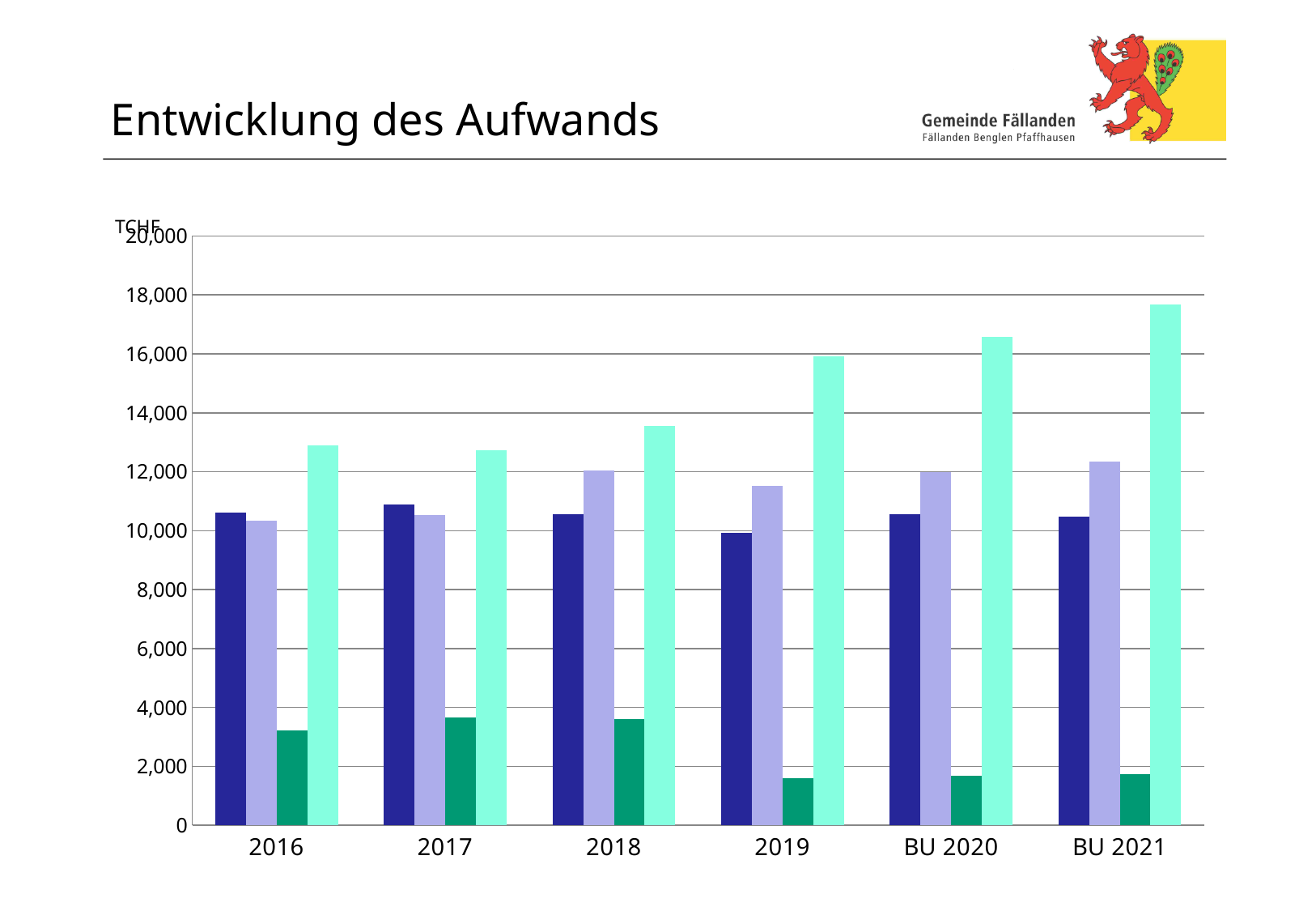
What unit label is shown at the top of the y axis? TCHF Is the value of the green bar for 2017 greater or less than 4,000? less Is the value of the light cyan bar for BU 2021 greater or less than 16,000? greater What kind of chart is shown on the slide? bar chart How many bars are plotted for each category? 4 Do the light cyan bars rise or fall from 2018 to BU 2021? rise How many categories are shown along the x axis? 6 Is the value of the light cyan bar for 2016 greater or less than 12,000? greater Which category has the tallest light cyan bar? BU 2021 Which category has the shortest dark blue bar? 2019 In 2019, which is taller: the dark blue bar or the light purple bar? light purple bar